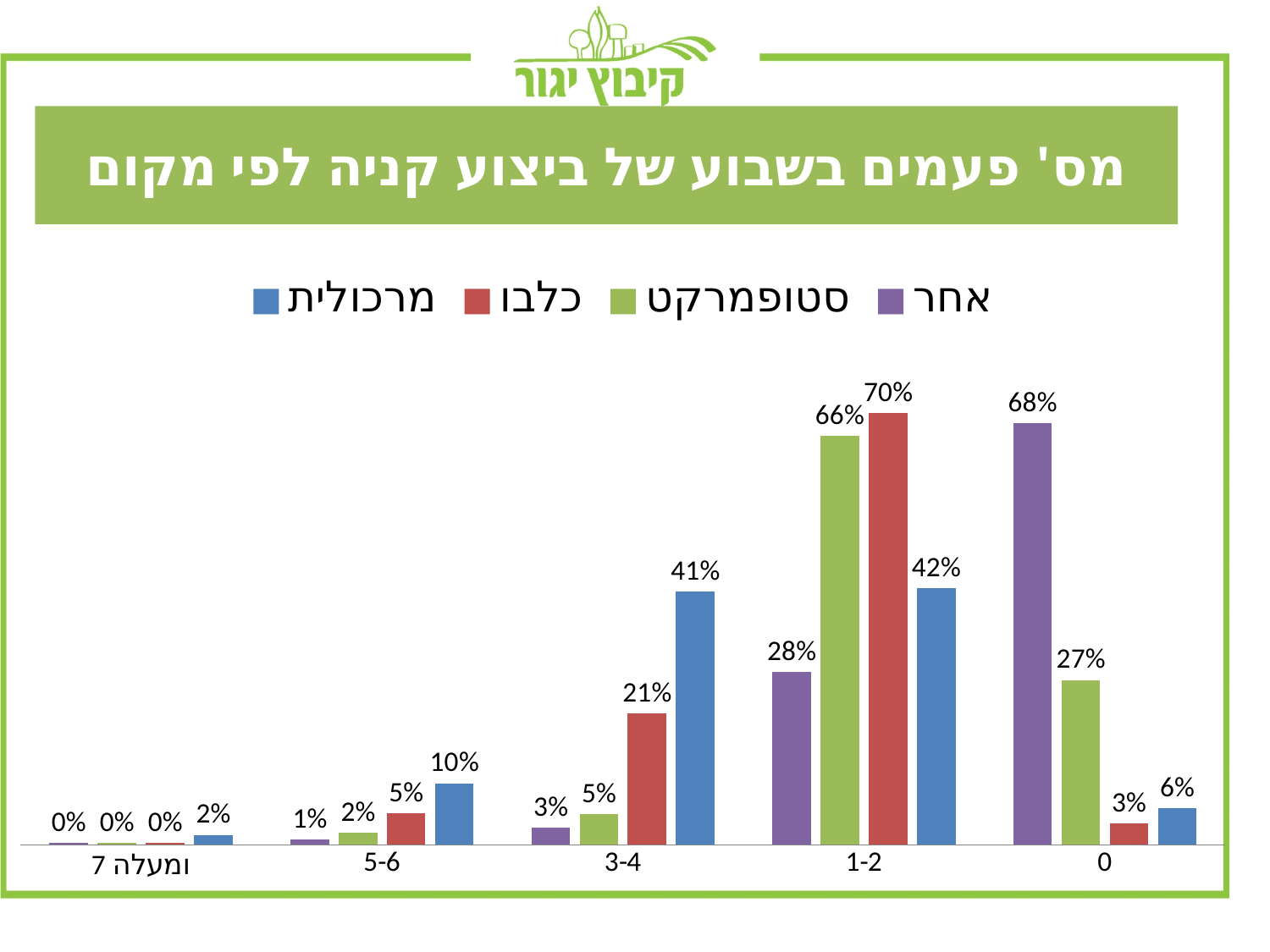
Which series has the lowest value in the 0 category? כלבו Which is larger in the 0 category: סטופמרקט or מרכולית? סטופמרקט What is the value for סטופמרקט in the 5-6 category? 2% Which series has the highest value in the 1-2 category? כלבו Which series is shown in blue in the legend? מרכולית How many categories are shown on the x axis? 5 What is the value for מרכולית in the 3-4 category? 41% What is the difference between the מרכולית value and the כלבו value in the 3-4 category? 20% What is the value for כלבו in the 1-2 category? 70% What is the value for אחר in the 0 category? 68% What type of chart is shown on the slide? bar chart How many series does the legend list? 4